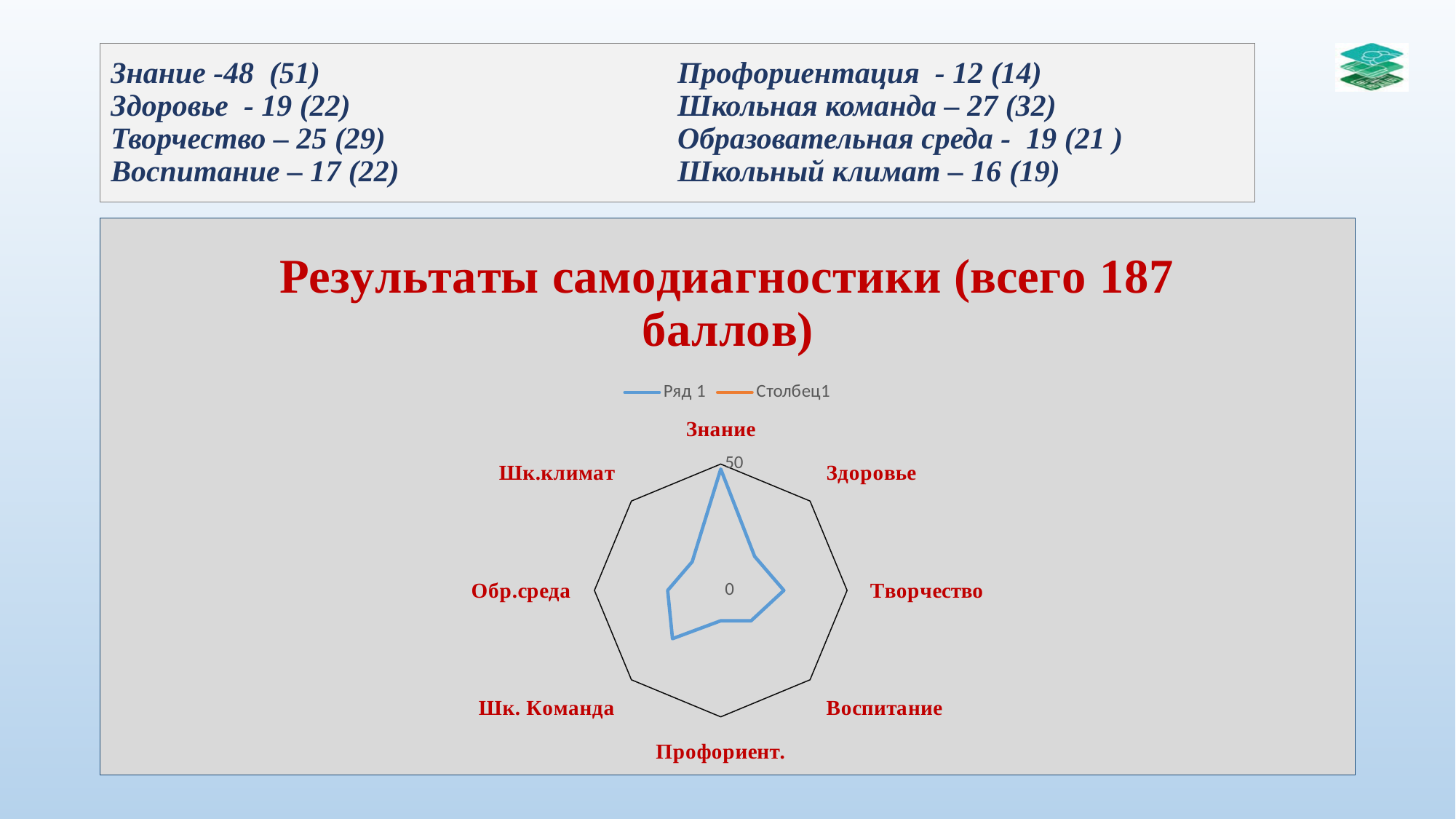
Is the value for Творчество greater or less than 50? less How many categories (axes) does the radar chart have? 8 What are the two series names shown in the chart legend? Ряд 1 and Столбец1 Which is larger on the radar chart, the value for Знание or the value for Здоровье? Знание Which is larger on the radar chart, the value for Творчество or the value for Профориент.? Творчество How many series does the chart legend list? 2 What kind of chart is shown on the slide? Radar chart What is the maximum value shown on the radar chart's axis scale? 50 Which category has the highest value on the radar chart? Знание What is the title of the chart? Результаты самодиагностики (всего 187 баллов) Which category has the lowest value on the radar chart? Профориент. Is the value for Здоровье greater or less than 50? less